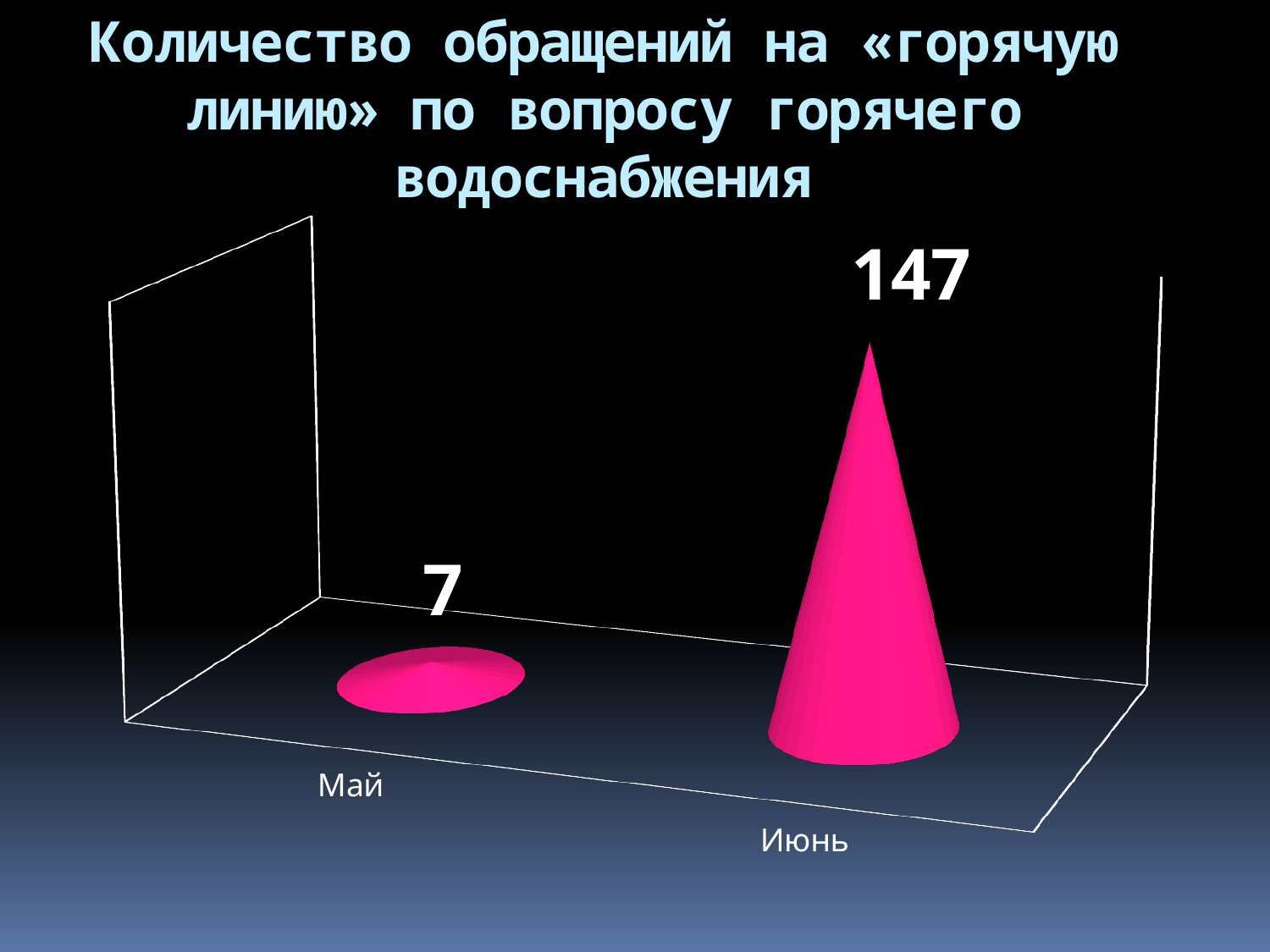
What kind of chart is shown on the slide? bar chart How many categories are shown on the chart? 2 Which is larger, the value for Май or the value for Июнь? Июнь What is the difference between the values for Июнь and Май? 140 What colour are the bars on the chart? pink What is the title of the chart on the slide? Количество обращений на «горячую линию» по вопросу горячего водоснабжения What is the total of the values for Май and Июнь? 154 Which category has the lowest value? Май Which category has the highest value? Июнь What is the value for Май (May)? 7 Do the values rise or fall from Май to Июнь? rise What is the value for Июнь (June)? 147